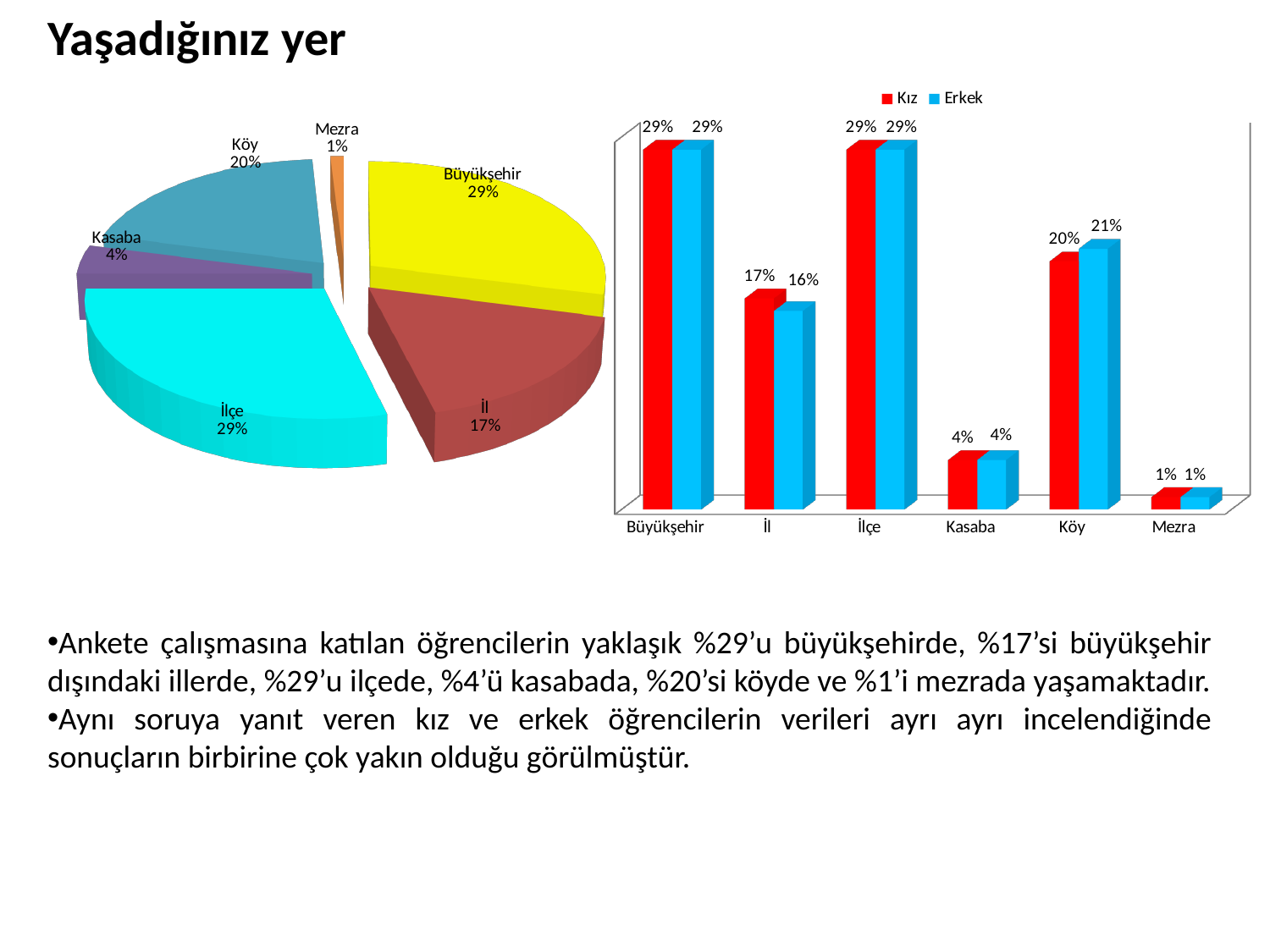
In the bar chart on the right, how many series does the legend list? 2 In the bar chart on the right, which is larger for Köy, the Kız value or the Erkek value? Erkek In the bar chart on the right, what is the difference between the Kız and Erkek values for İl? 1% What kind of chart is on the right side of the slide? Bar chart In the pie chart on the left, which category has the smallest share? Mezra In the bar chart on the right, what is the Kız value for İl? 17% In the bar chart on the right, what colour represents the Kız series? Red In the bar chart on the right, which category has the lowest Kız value? Mezra In the bar chart on the right, what is the Erkek value for Köy? 21% In the pie chart on the left, how many categories are shown? 6 In the pie chart on the left, what share does Köy have? 20% In the pie chart on the left, what share does Kasaba have? 4%